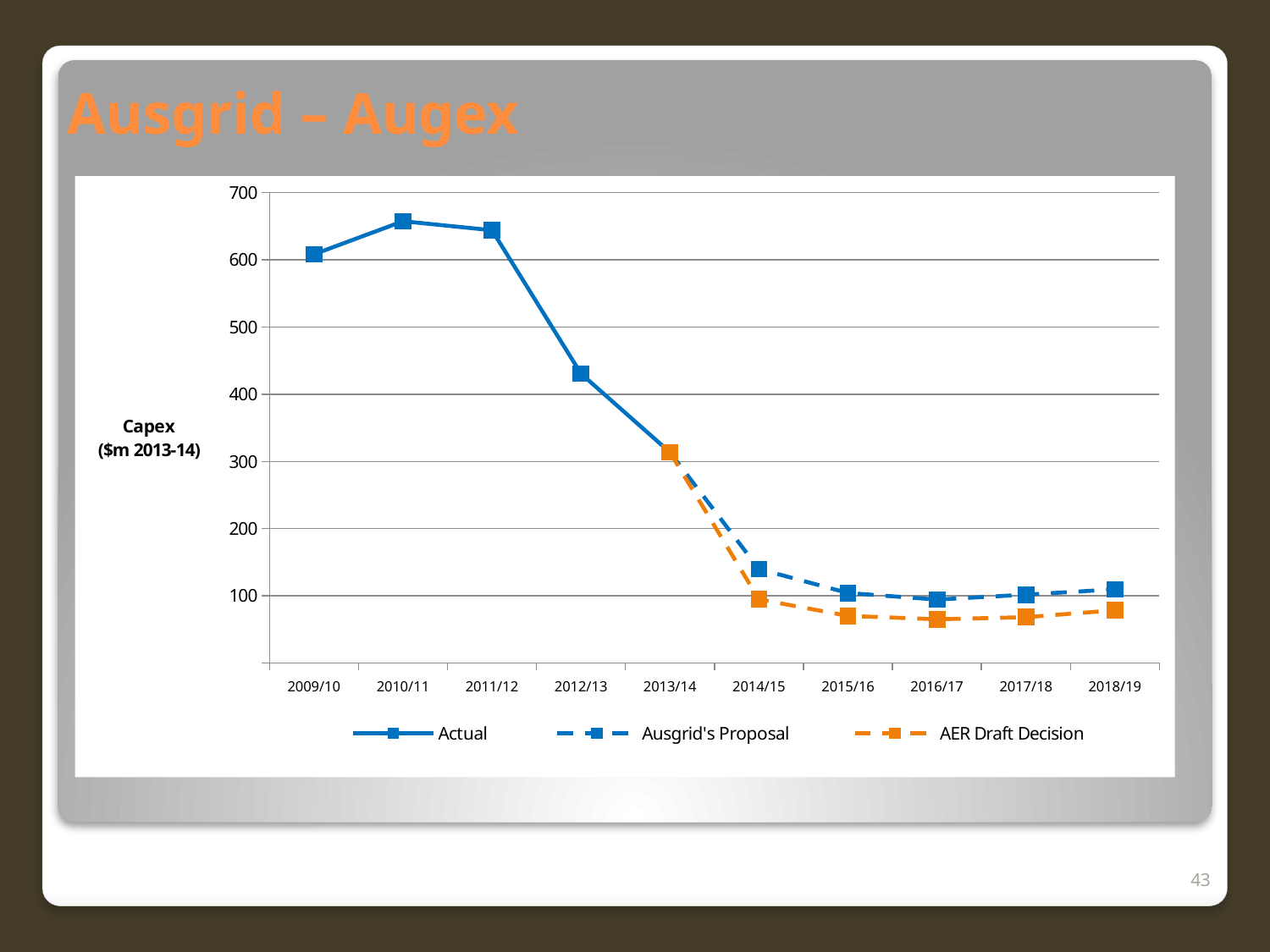
What kind of chart is shown on the slide? line chart In which year does the Actual series reach its highest value? 2010/11 How many series does the legend list? 3 In 2014/15, which is larger: Ausgrid's Proposal or AER Draft Decision? Ausgrid's Proposal Is the Actual value for 2010/11 greater or less than 700? less Is the Ausgrid's Proposal value for 2014/15 greater or less than 100? greater Is the Actual value for 2012/13 greater or less than 400? greater How many years are shown on the x axis? 10 Does the Actual series rise or fall from 2010/11 to 2013/14? fall What is the title of the slide containing the chart? Ausgrid – Augex What is the label on the vertical axis of the chart? Capex ($m 2013-14)